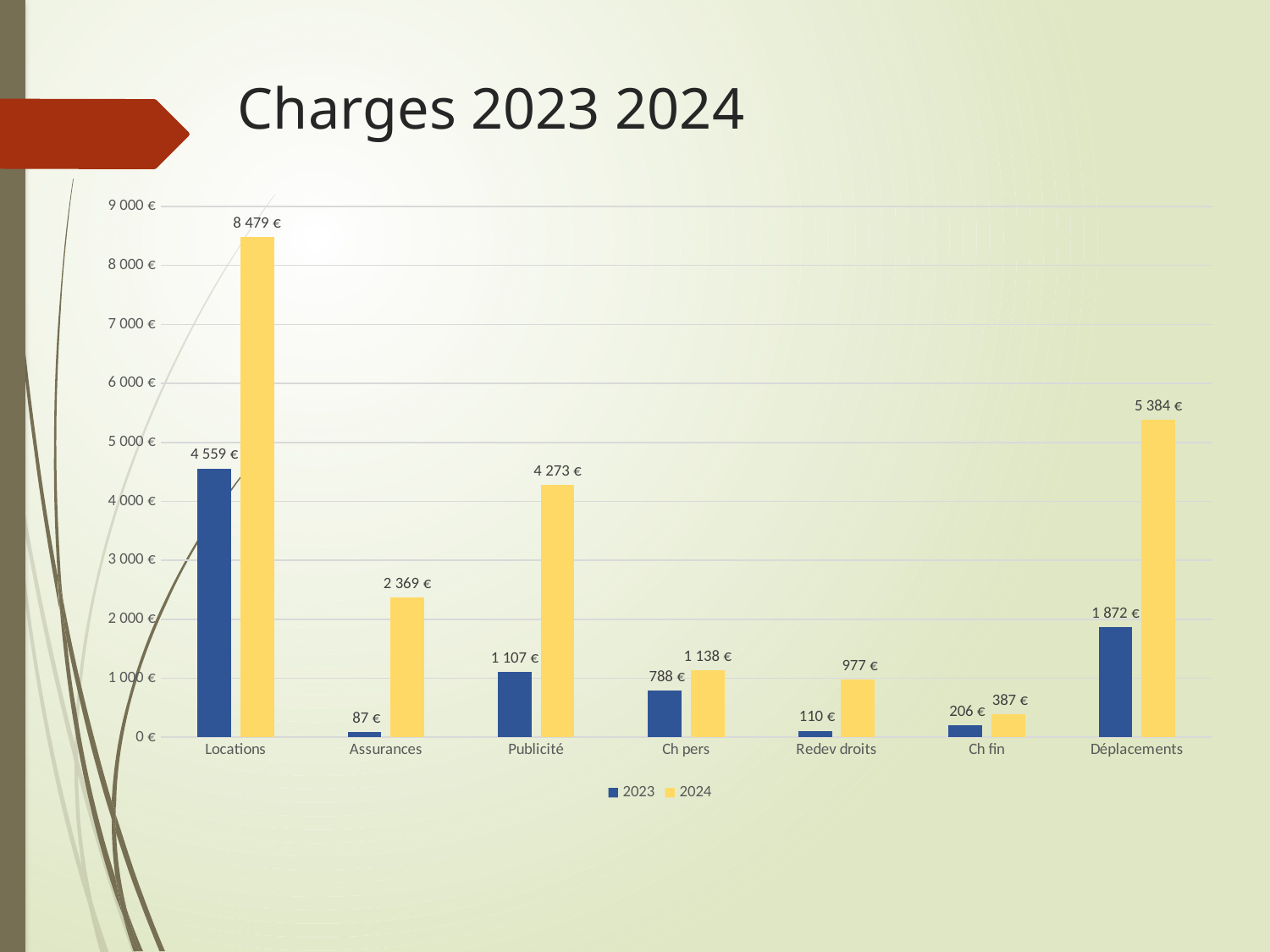
Which category has the highest 2024 value? Locations How many series does the legend list? 2 How many categories are shown on the x axis? 7 What is the 2023 value for Assurances? 87 € What is the 2024 value for Déplacements? 5 384 € What type of chart is shown on the slide? Bar chart What is the 2024 value for Locations? 8 479 € What is the 2023 value for Publicité? 1 107 € What is the difference between the 2024 and 2023 values for Déplacements? 3 512 € Which category has the lowest 2023 value? Assurances Which is larger, the 2024 value for Publicité or the 2024 value for Assurances? Publicité What is the difference between the 2024 and 2023 values for Locations? 3 920 €